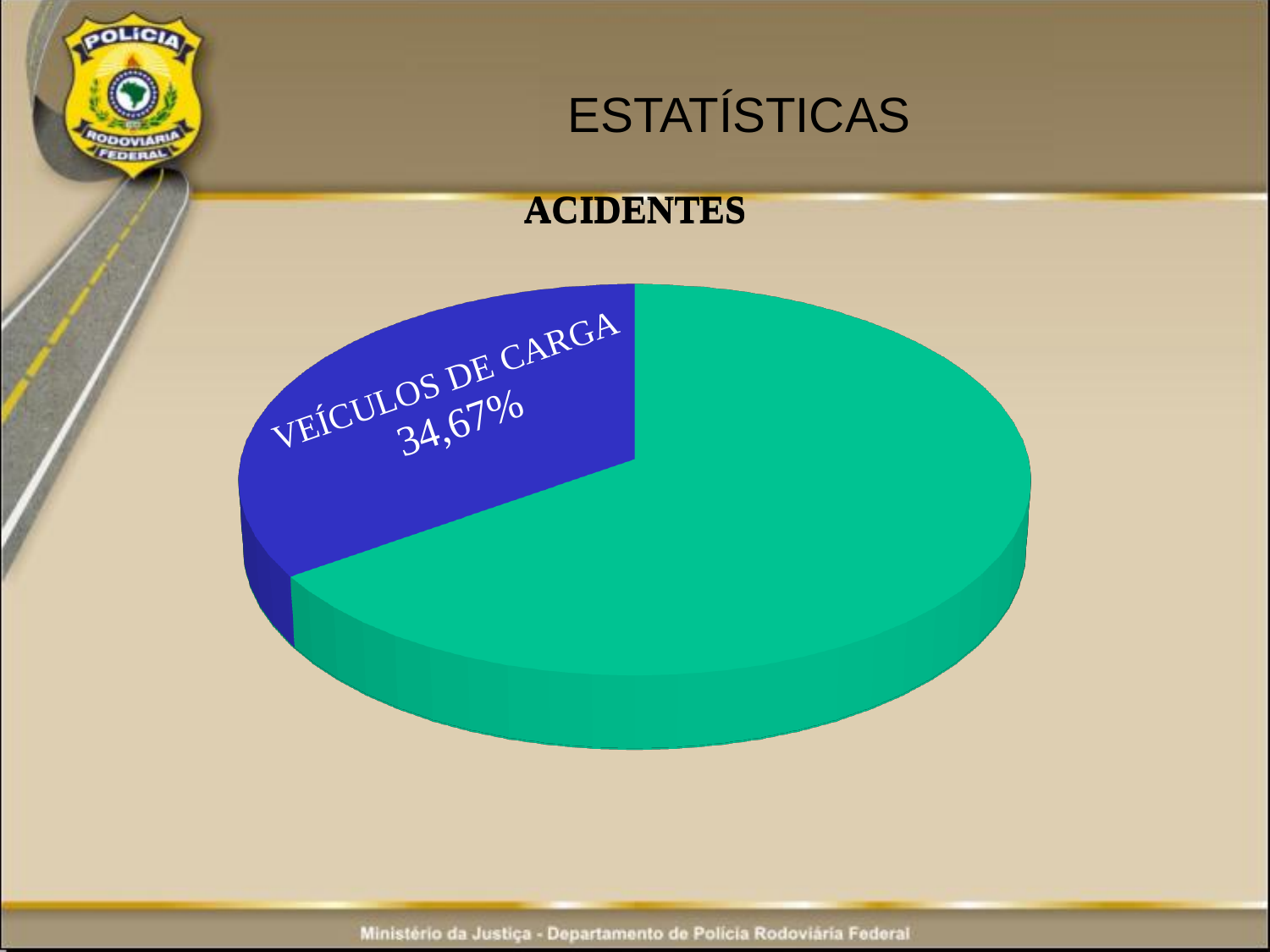
Which slice is larger, the VEÍCULOS DE CARGA slice or the green slice? the green slice What kind of chart is shown on the slide? pie chart What is the title of the chart? ACIDENTES What share of the pie does VEÍCULOS DE CARGA represent? 34,67% What colour is the VEÍCULOS DE CARGA slice? blue Is the share for VEÍCULOS DE CARGA greater or less than 50%? less Which slice is the smallest in the pie chart? VEÍCULOS DE CARGA How many slices does the pie chart have? 2